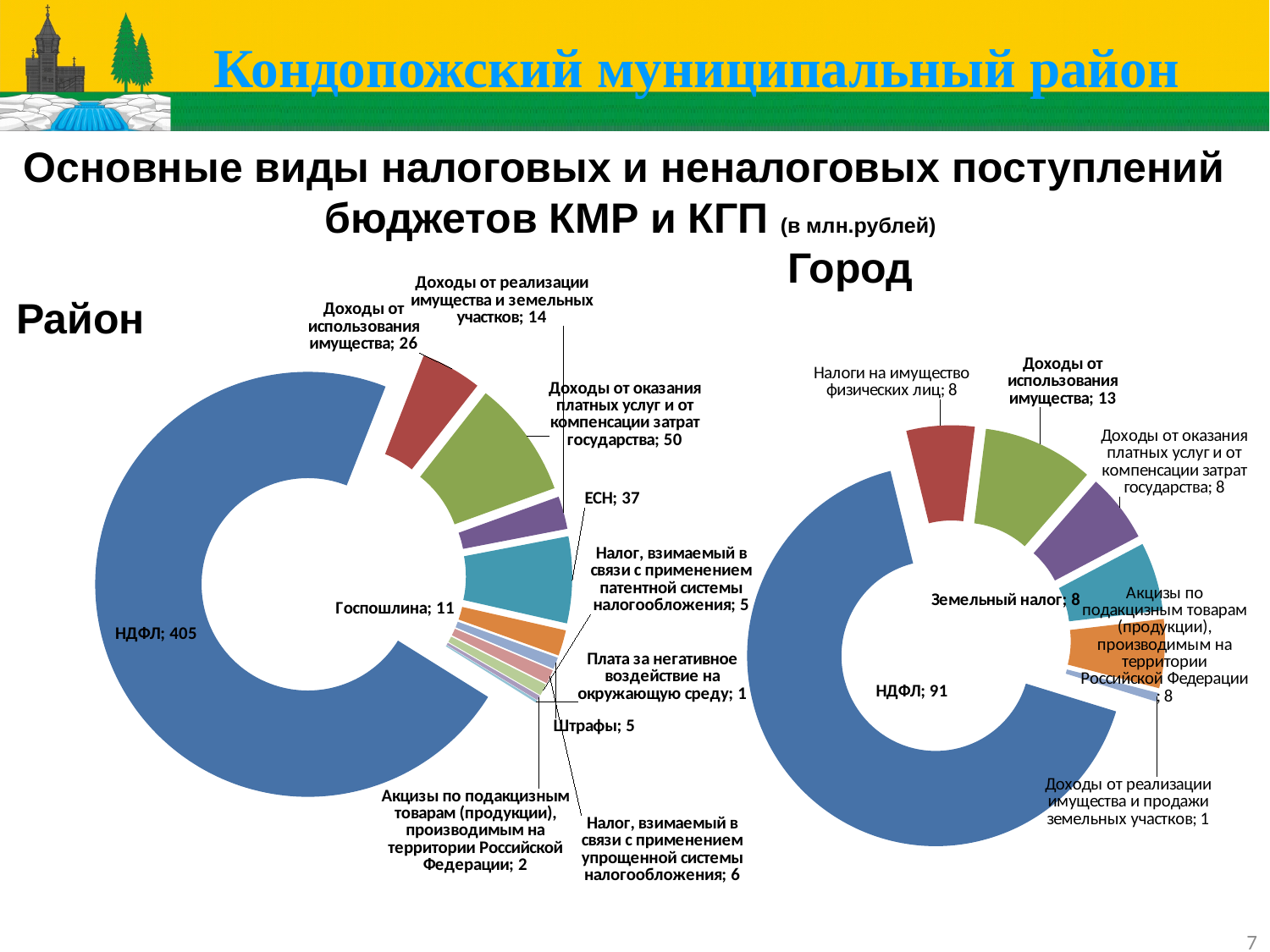
In the 'Город' chart, what is the value for 'Доходы от использования имущества'? 13 In the 'Район' chart, what is the difference between 'Доходы от оказания платных услуг и от компенсации затрат государства' and ЕСН? 13 What is the difference between the НДФЛ value in the 'Район' chart and the НДФЛ value in the 'Город' chart? 314 How many categories are shown in the 'Район' chart? 11 In the 'Район' chart, which is larger: 'Доходы от использования имущества' or 'Доходы от реализации имущества и земельных участков'? Доходы от использования имущества In the 'Район' chart, which category has the largest value? НДФЛ In the 'Город' chart, what is the value for НДФЛ? 91 What type of chart is used for 'Район' and 'Город'? Doughnut (pie) chart How many categories are shown in the 'Город' chart? 7 In the 'Район' chart, what is the value for ЕСН? 37 In the 'Город' chart, which category has the smallest value? Доходы от реализации имущества и продажи земельных участков In the 'Район' chart, what is the value for НДФЛ? 405